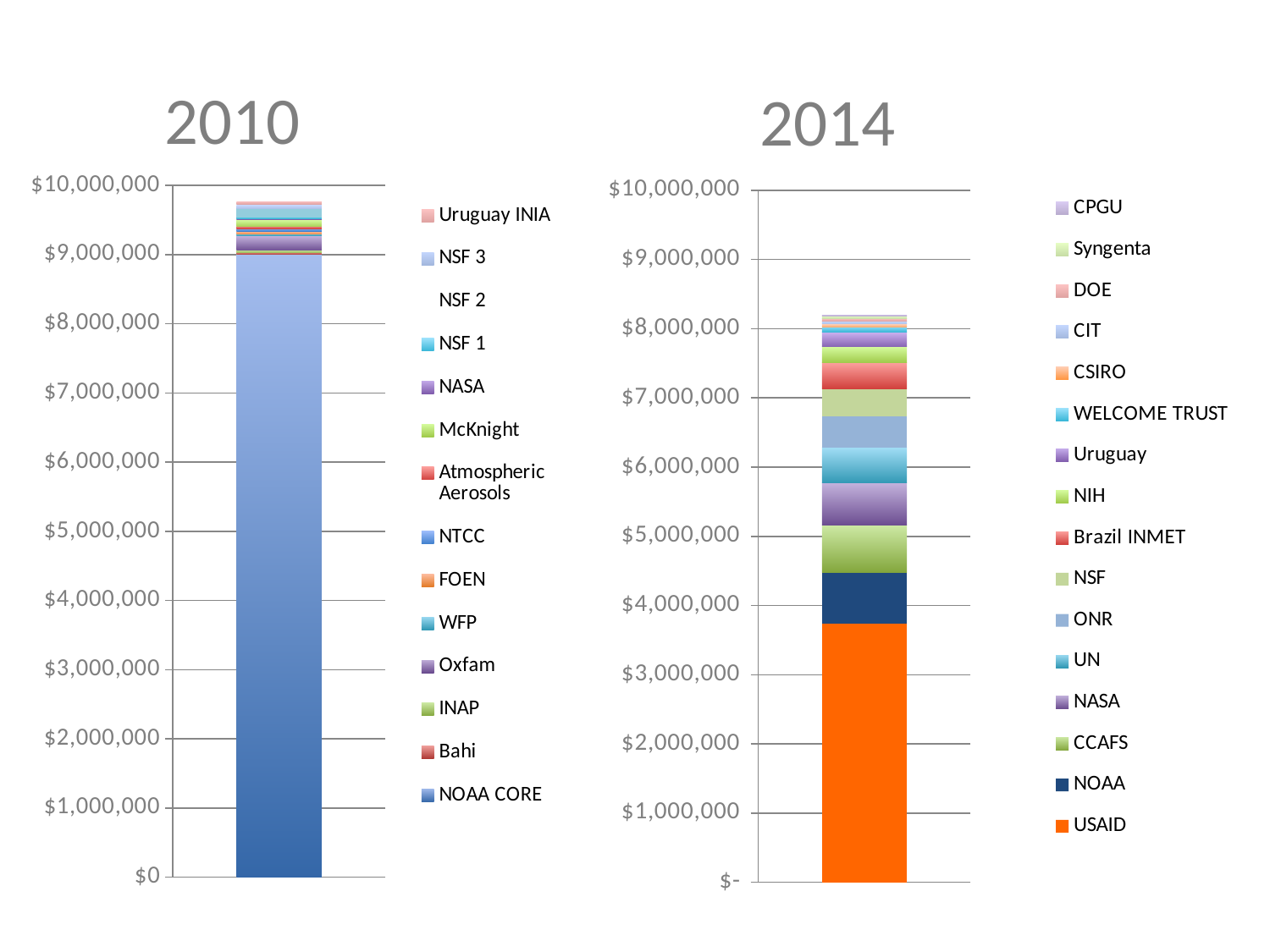
Is the total height of the bar in the 2010 chart greater or less than $9,000,000? greater In the 2014 chart, which series makes up the largest part of the bar? USAID In the 2014 chart, is the USAID segment greater or less than $3,000,000? greater In the 2010 chart, which series makes up the largest part of the bar? NOAA CORE Which bar is taller, the 2010 bar or the 2014 bar? 2010 In the 2014 chart, is the USAID segment greater or less than $4,000,000? less How many series does the legend of the 2014 chart list? 16 What kind of chart is the 2010 chart? stacked bar chart In the 2014 chart, which series is listed at the bottom of the legend? USAID How many series does the legend of the 2010 chart list? 14